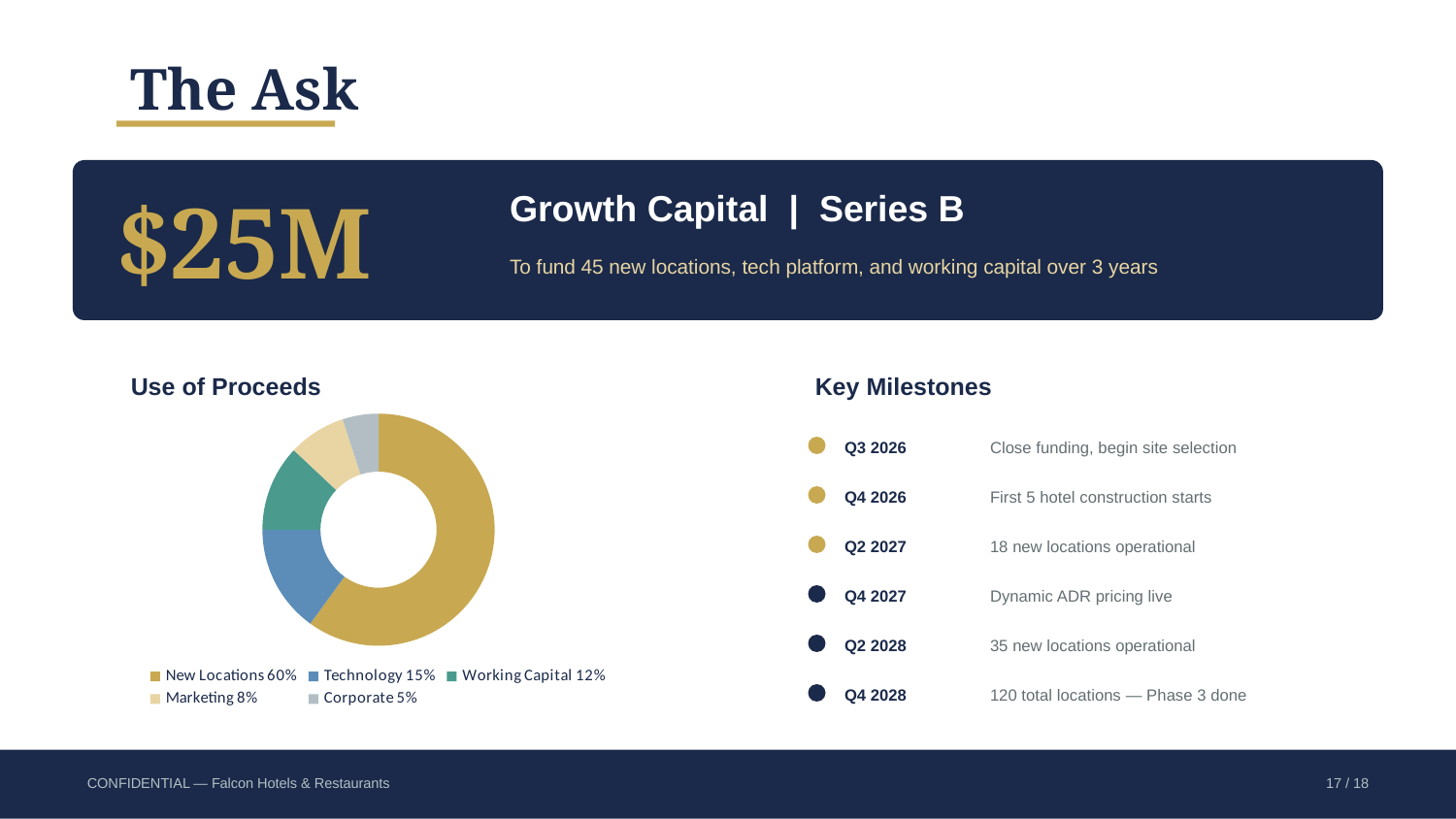
How many categories does the Use of Proceeds chart show? 5 What is the difference between the New Locations share and the Technology share? 45 percentage points Which category receives the smallest share of proceeds? Corporate What share of proceeds goes to New Locations in the Use of Proceeds chart? 60% Which category receives the largest share of proceeds? New Locations What share of proceeds goes to Marketing? 8% What is the title of the chart on the slide? Use of Proceeds What percentage of proceeds is allocated to Working Capital? 12% What share of proceeds is allocated to Technology? 15% How many percentage points larger is the Technology share than the Corporate share? 10 percentage points What type of chart is used for Use of Proceeds? Donut (pie) chart Which is larger, the share for Working Capital or the share for Marketing? Working Capital